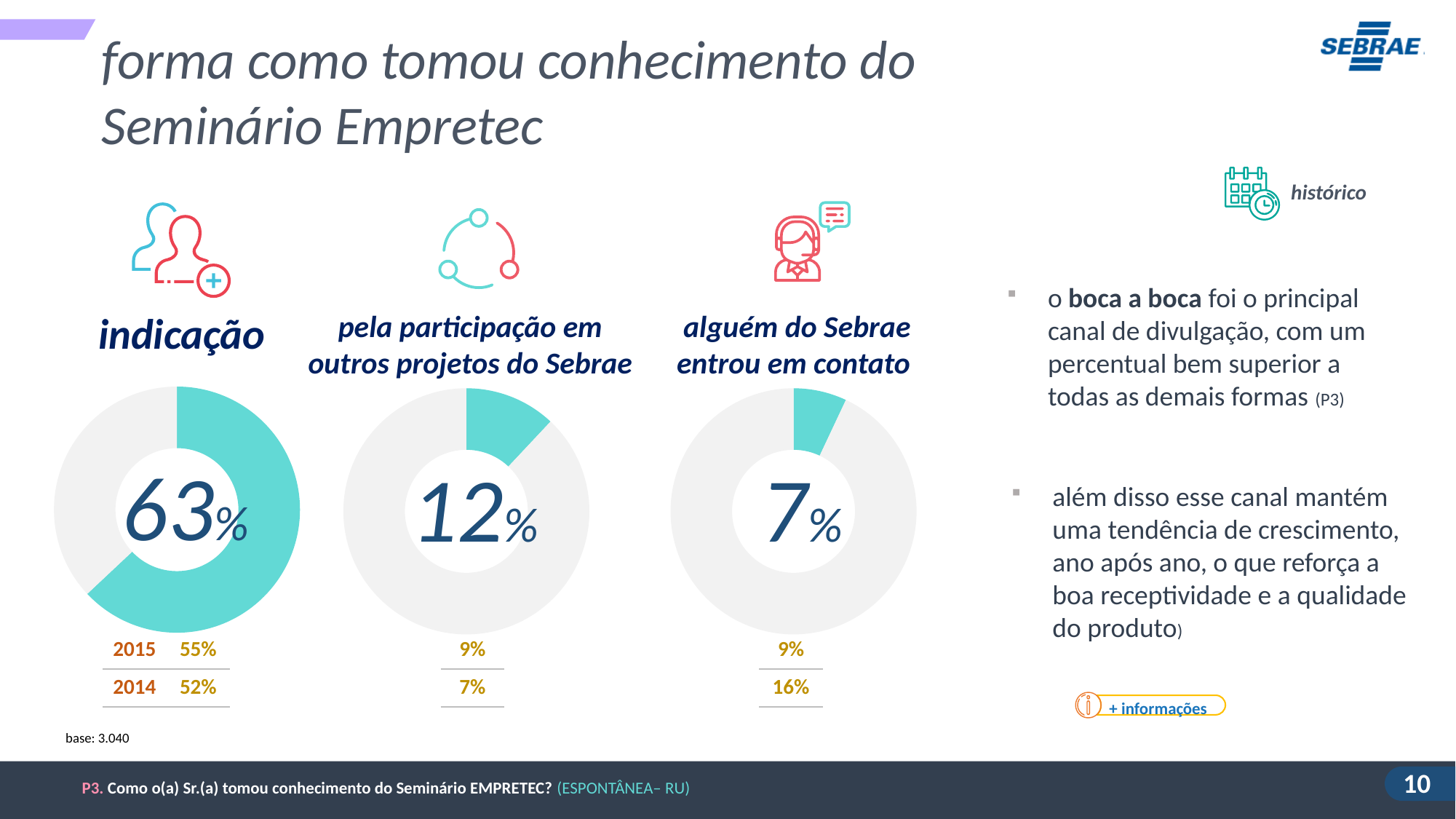
In the "pela participação em outros projetos do Sebrae" chart, what percentage is shown? 12% In the "alguém do Sebrae entrou em contato" chart, what percentage is shown? 7% Which of the three donut charts shows the highest percentage? indicação What kind of chart is used to show the share for "indicação"? donut chart How many donut charts are shown on the slide? 3 In the "indicação" chart, what percentage is shown in the centre? 63% Which of the three donut charts shows the lowest percentage? alguém do Sebrae entrou em contato Below the "indicação" chart, what value is shown for 2015? 55% Below the "alguém do Sebrae entrou em contato" chart, what value is shown for 2014? 16% Below the "indicação" chart, what value is shown for 2014? 52% What is the difference between the "indicação" percentage and the "pela participação em outros projetos do Sebrae" percentage? 51 percentage points Is the "indicação" percentage greater or less than 50%? greater